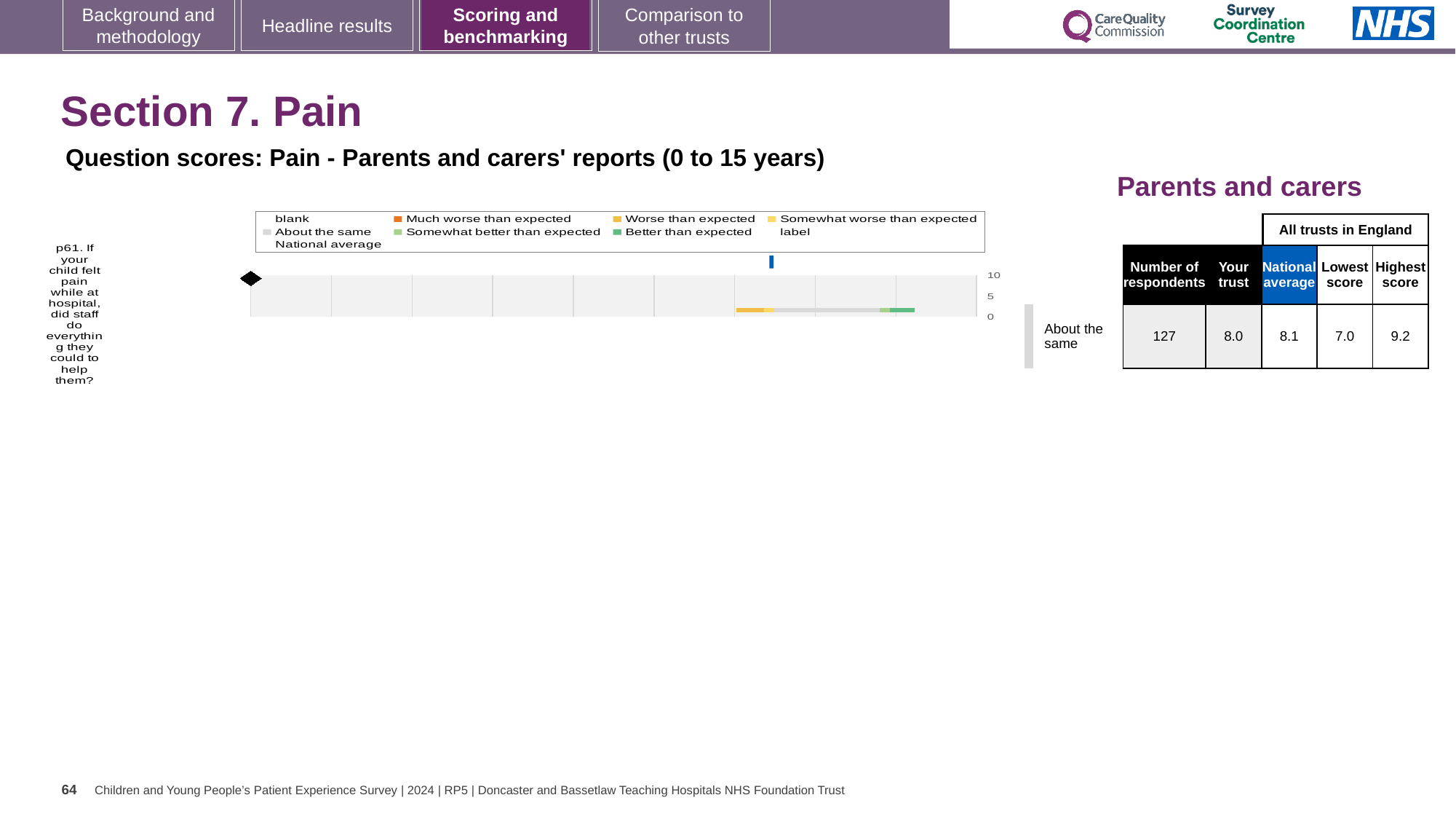
How many respondents answered question p61, according to the table next to the chart? 127 What is the question number of the item plotted in the chart? p61 What kind of chart is shown on the slide? bar chart According to the table next to the chart, what is the highest score among all trusts in England for question p61? 9.2 What is the highest value shown on the chart's score axis? 10 According to the table next to the chart, what is the lowest score among all trusts in England for question p61? 7.0 How many survey questions (categories) are plotted in the chart? 1 According to the table next to the chart, what is the national average score for question p61? 8.1 Which is larger for question p61: the 'Your trust' score or the national average? National average According to the table next to the chart, what is the 'Your trust' score for question p61? 8.0 What is the difference between the highest score and the lowest score for question p61 in the table? 2.2 Is the 'Your trust' score for question p61 greater or less than 5 on the chart's axis? greater